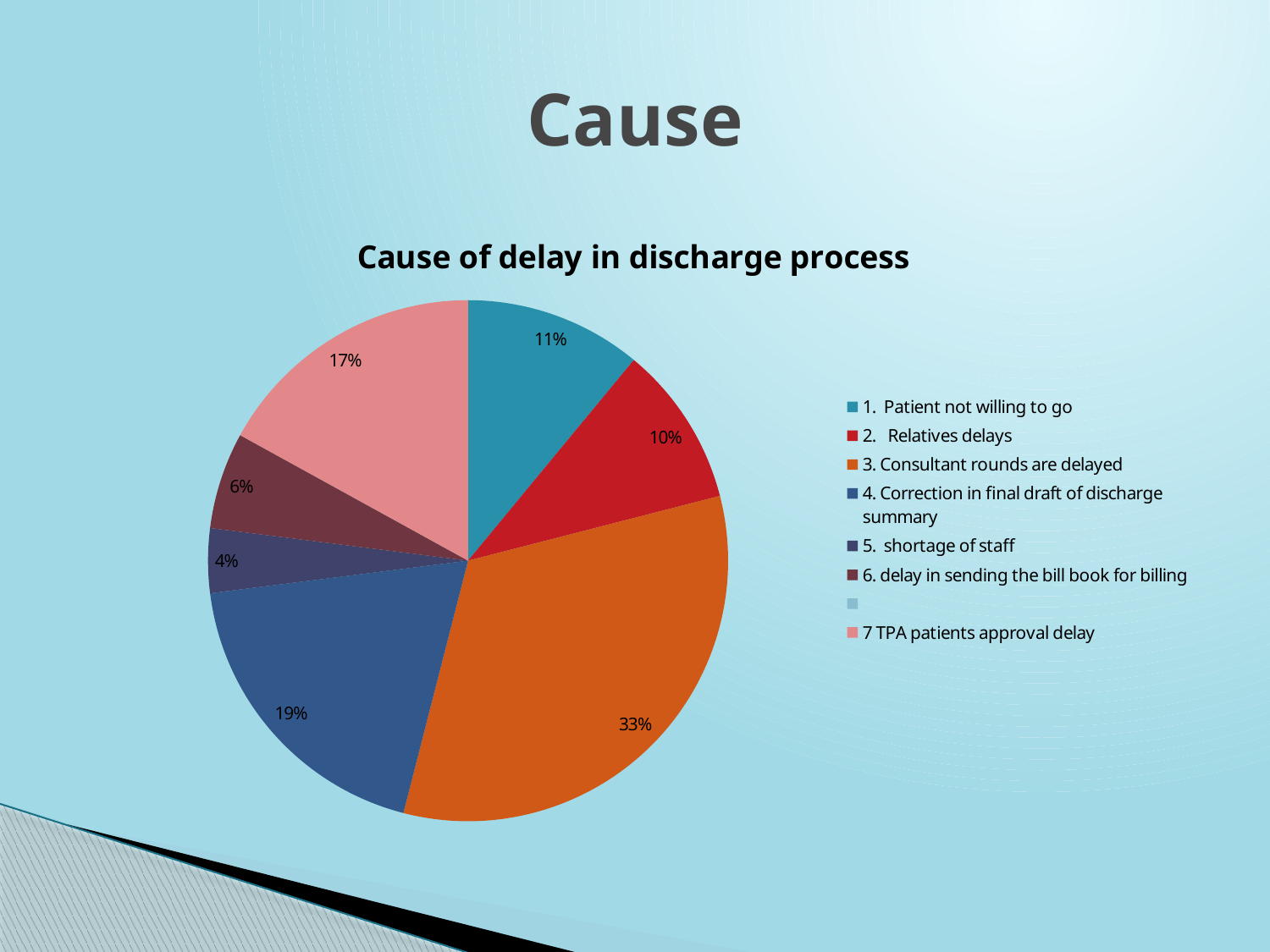
What percentage of the pie is attributed to '3. Consultant rounds are delayed'? 33% Which is larger: the share for '2. Relatives delays' or the share for '6. delay in sending the bill book for billing'? 2. Relatives delays How many slices of the pie have a percentage label? 7 Which cause has the smallest share of the pie? 5. shortage of staff What percentage of the pie is attributed to '1. Patient not willing to go'? 11% What percentage of the pie is attributed to '7 TPA patients approval delay'? 17% What is the difference in percentage points between '3. Consultant rounds are delayed' and '4. Correction in final draft of discharge summary'? 14 What is the title of the chart? Cause of delay in discharge process What kind of chart is shown on the slide? pie chart Which cause has the largest share of the pie? 3. Consultant rounds are delayed What percentage of the pie is attributed to '5. shortage of staff'? 4% What colour is the slice for '4. Correction in final draft of discharge summary'? blue